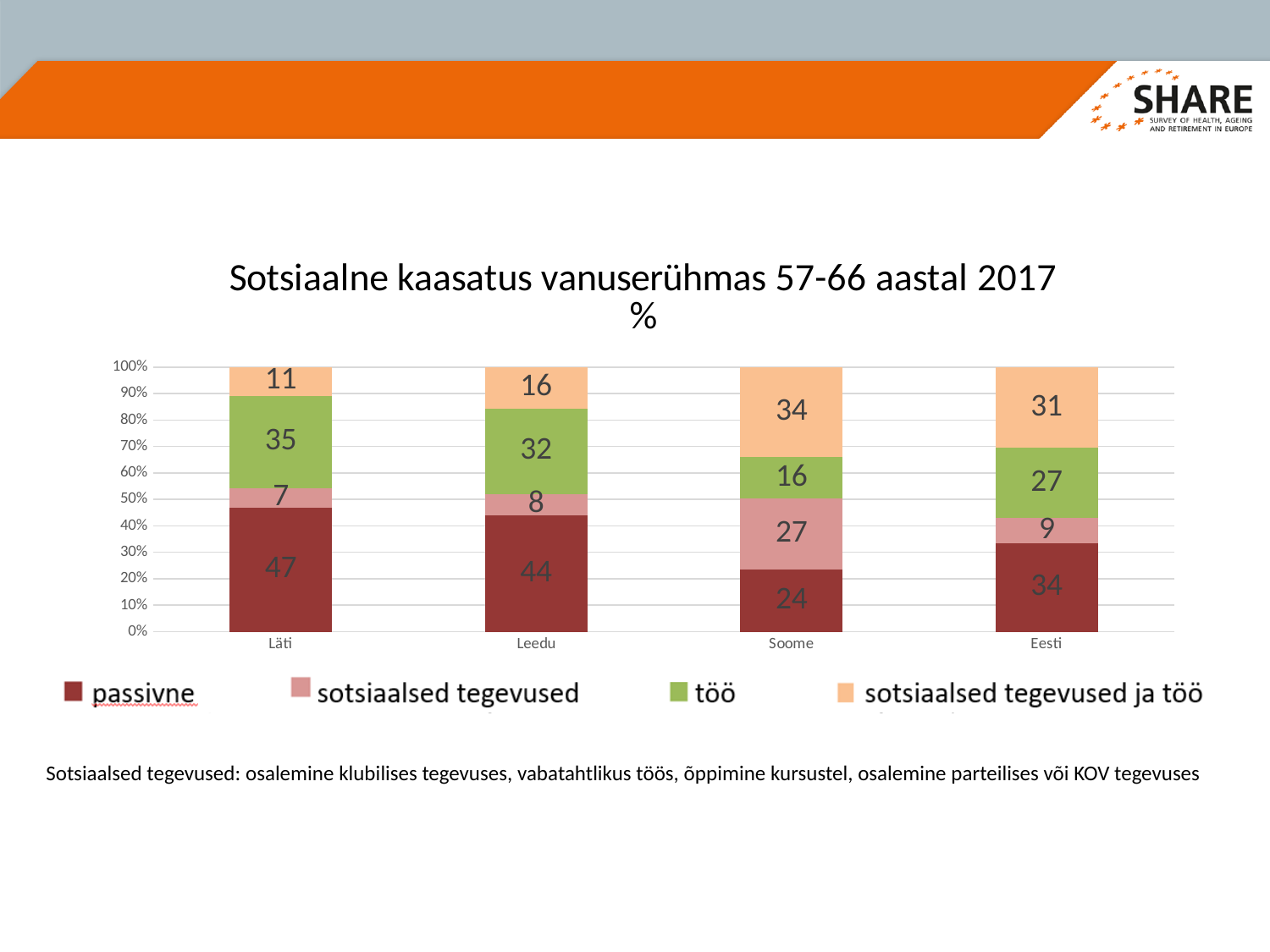
Which is larger, the sotsiaalsed tegevused ja töö value for Eesti or for Leedu? Eesti What is the value for sotsiaalsed tegevused ja töö in Soome? 34 Which country has the lowest value for töö? Soome How many countries are shown on the x axis? 4 What is the title of the chart? Sotsiaalne kaasatus vanuserühmas 57-66 aastal 2017 % What is the value for passiivne in Läti? 47 Which country has the highest value for passiivne? Läti How many series does the legend list? 4 What is the value for sotsiaalsed tegevused in Leedu? 8 What is the value for töö in Eesti? 27 What kind of chart is shown on the slide? Stacked bar chart What is the difference between the passiivne values for Läti and Soome? 23